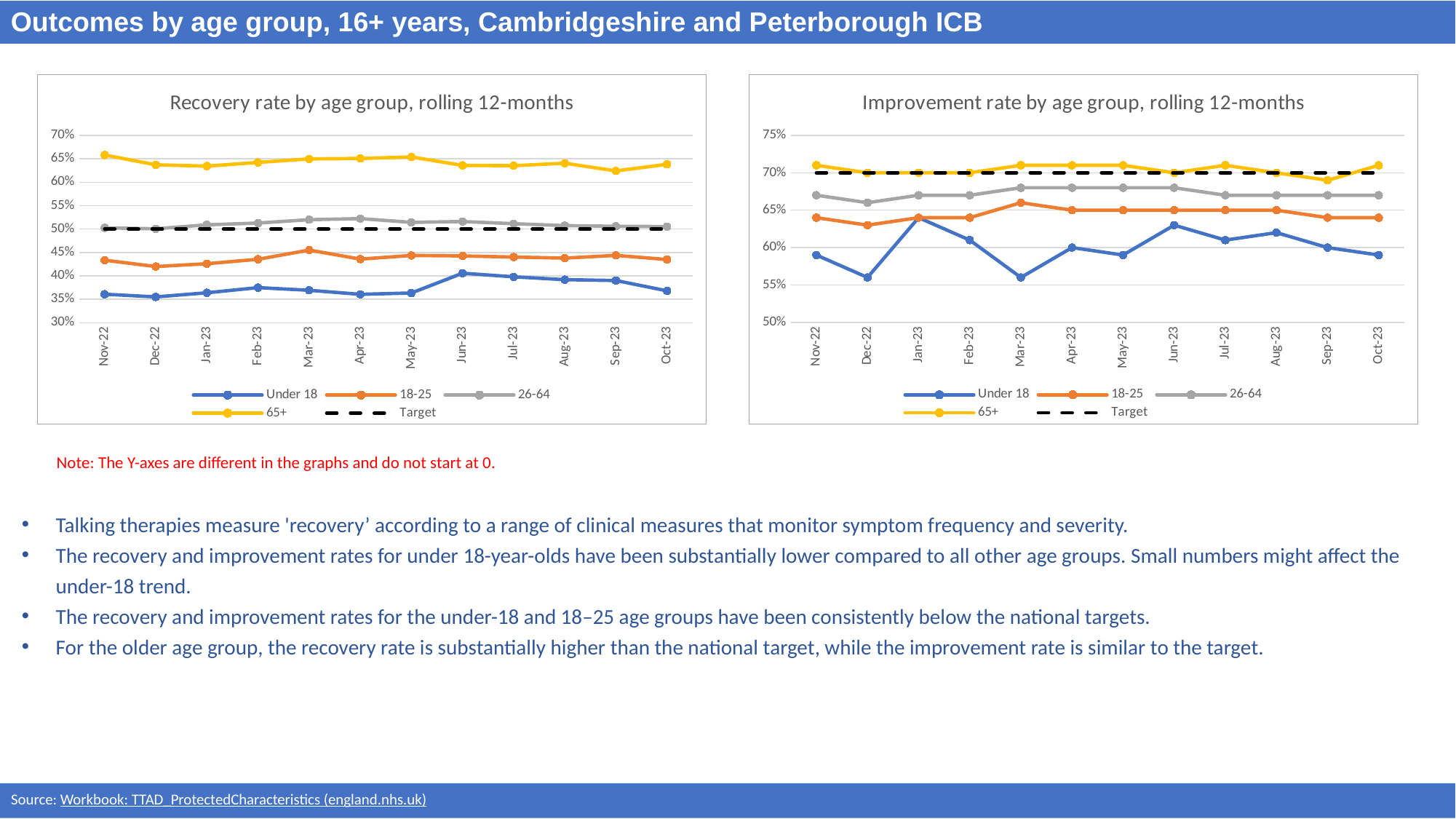
On the 'Recovery rate by age group, rolling 12-months' chart, is the value for Under 18 in Dec-22 greater or less than 40%? less On the 'Recovery rate by age group, rolling 12-months' chart, is the value for 18-25 in Mar-23 greater or less than 50%? less On the 'Improvement rate by age group, rolling 12-months' chart, which age group is shown in orange? 18-25 On the 'Improvement rate by age group, rolling 12-months' chart, what value does the Target line sit at? 70% On the 'Recovery rate by age group, rolling 12-months' chart, what value does the Target line sit at? 50% On the 'Improvement rate by age group, rolling 12-months' chart, which is larger for Under 18: the value in Jan-23 or the value in Mar-23? Jan-23 On the 'Improvement rate by age group, rolling 12-months' chart, is the value for Under 18 in Dec-22 greater or less than 60%? less On the 'Recovery rate by age group, rolling 12-months' chart, how many series does the legend list? 5 On the 'Recovery rate by age group, rolling 12-months' chart, what kind of chart is shown? Line chart On the 'Improvement rate by age group, rolling 12-months' chart, how many months are plotted along the x axis? 12 On the 'Recovery rate by age group, rolling 12-months' chart, which age group has the lowest recovery rate across the period? Under 18 On the 'Recovery rate by age group, rolling 12-months' chart, which age group has the highest recovery rate across the period? 65+